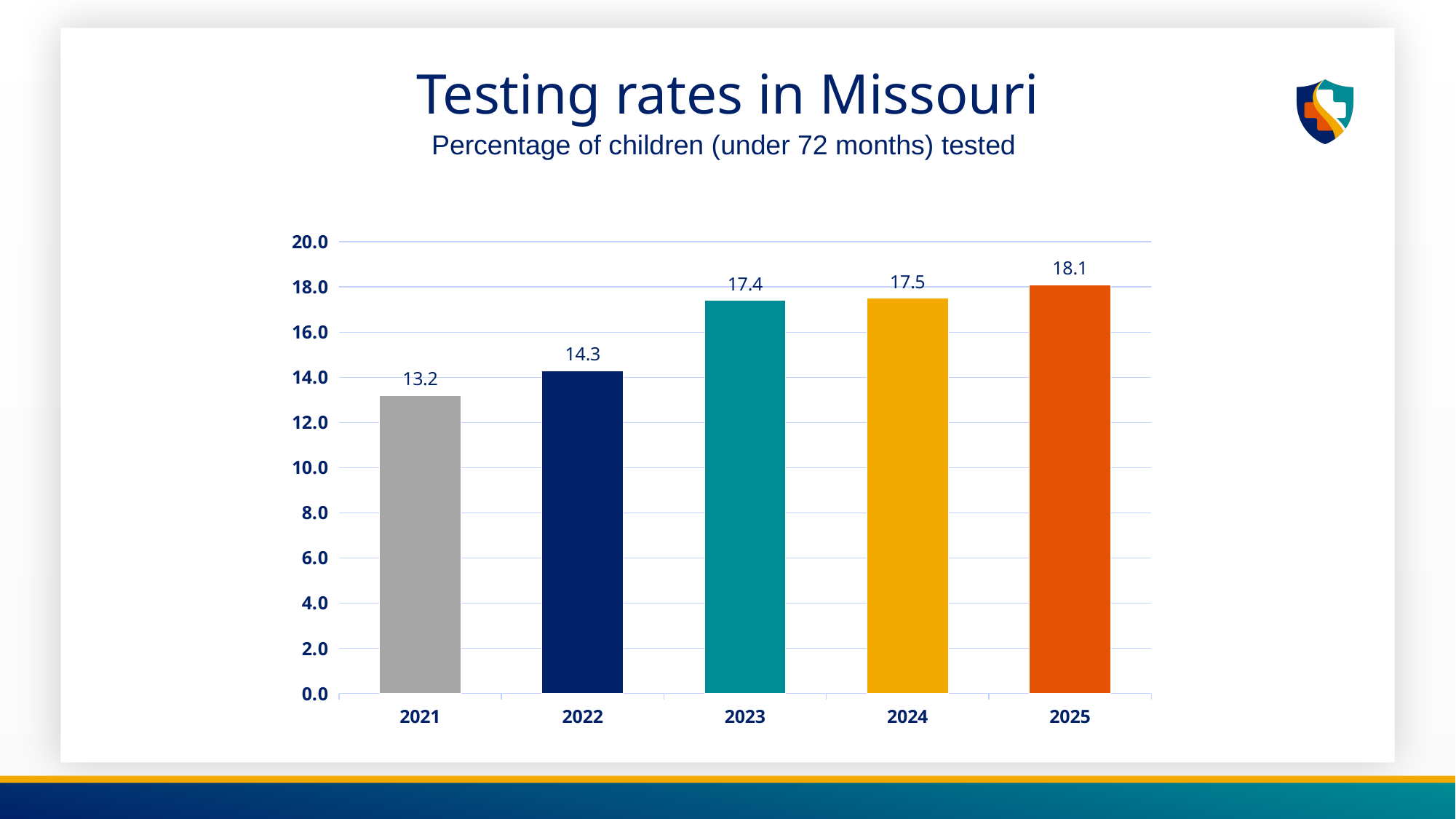
Which year has a higher testing rate, 2022 or 2024? 2024 What is the testing rate for 2025? 18.1 Which year has the highest testing rate? 2025 How many years are shown on the chart? 5 What is the testing rate for 2021? 13.2 What is the difference between the testing rates for 2025 and 2021? 4.9 Do the testing rates rise or fall from 2021 to 2025? Rise What kind of chart is shown on the slide? Bar chart What is the difference between the testing rates for 2023 and 2022? 3.1 Is the value for 2022 greater or less than 16.0? less What is the testing rate for 2023? 17.4 Which year has the lowest testing rate? 2021